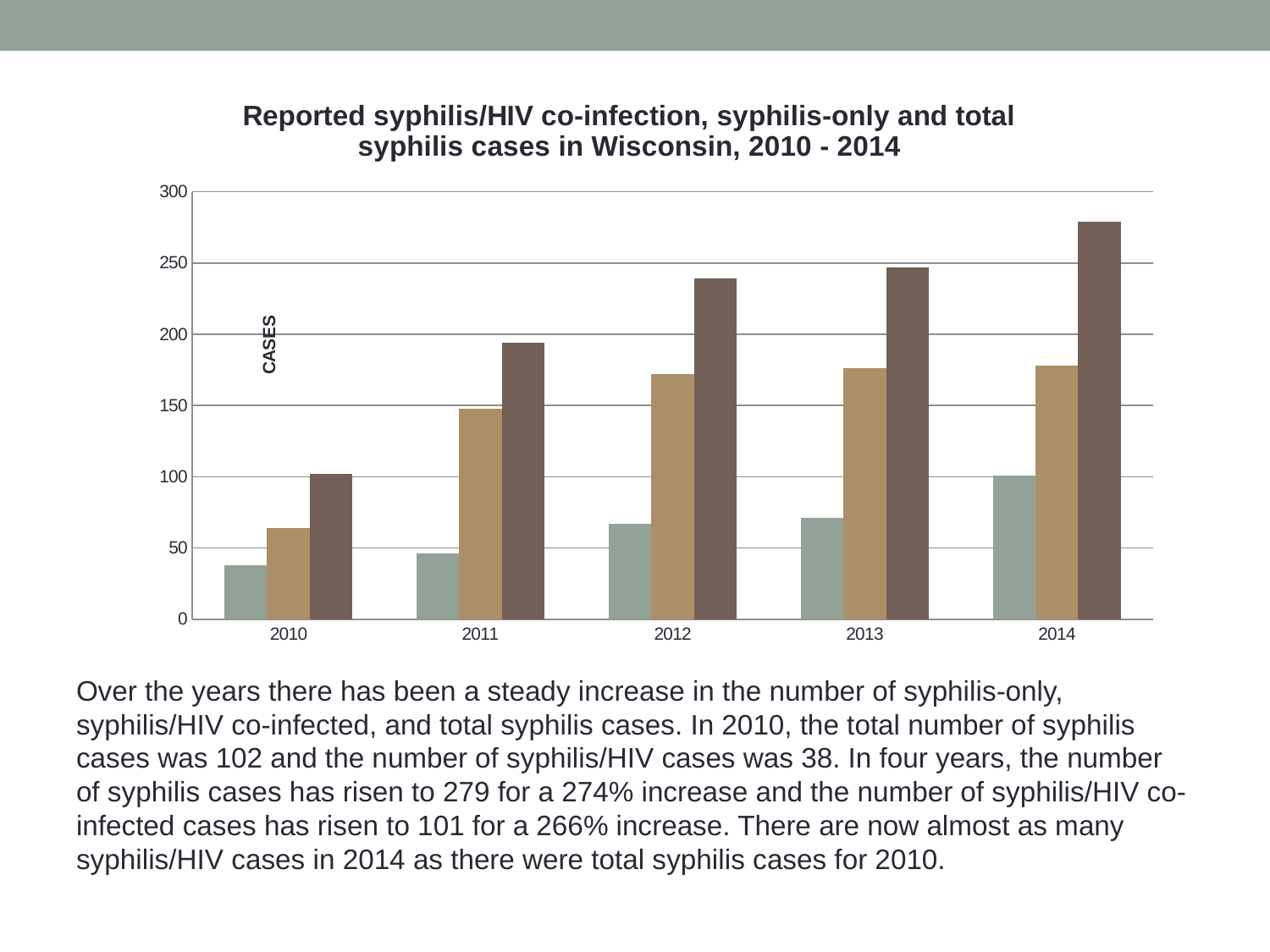
How many years are shown on the x axis of the chart? 5 Is the value of the tallest bar for 2012 greater or less than 200? greater What was the number of syphilis/HIV co-infected cases in 2010? 38 What was the number of syphilis/HIV co-infected cases in 2014? 101 What kind of chart is shown on the slide? bar chart What was the total number of syphilis cases in Wisconsin in 2010? 102 What is the label on the vertical axis of the chart? CASES By how much did the total number of syphilis cases increase from 2010 to 2014? 177 Which year has the shortest bar in the chart? 2010 Which year has the tallest bar in the chart? 2014 What was the total number of syphilis cases in 2014? 279 Do the total syphilis cases rise or fall from 2010 to 2014? rise